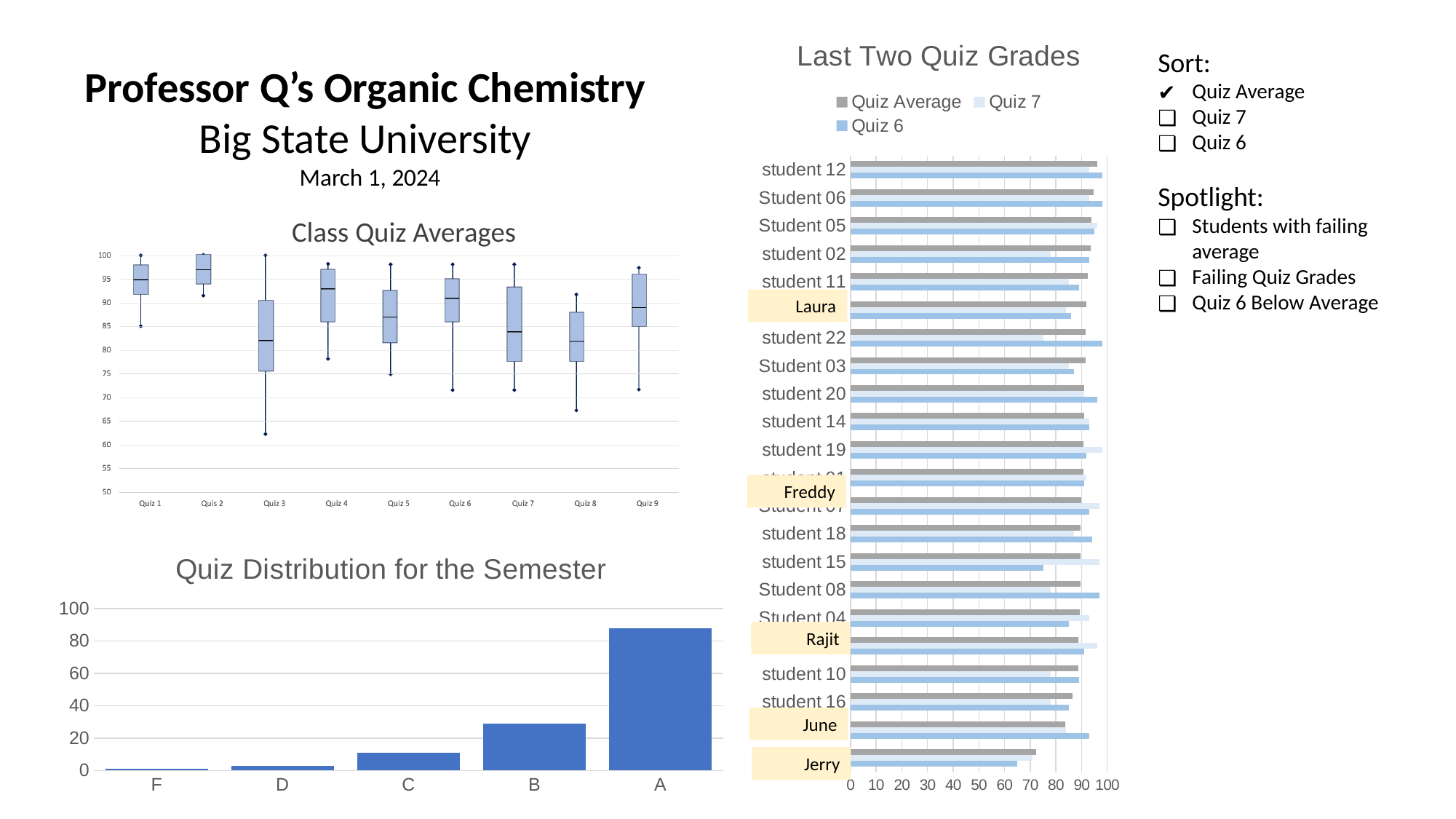
In the "Quiz Distribution for the Semester" chart, is the value for A greater or less than 80? greater What type of chart is "Quiz Distribution for the Semester"? bar chart In the "Last Two Quiz Grades" chart, is Jerry's Quiz Average greater or less than 80? less In the "Quiz Distribution for the Semester" chart, do the values rise or fall moving from F to A along the x axis? rise In the "Quiz Distribution for the Semester" chart, which is larger, the value for B or the value for D? B In the "Quiz Distribution for the Semester" chart, which grade category has the lowest bar? F In the "Last Two Quiz Grades" chart, which student has the lowest Quiz Average? Jerry How many quizzes are shown on the x axis of the "Class Quiz Averages" chart? 9 In the "Quiz Distribution for the Semester" chart, is the value for C greater or less than 20? less How many series does the legend of the "Last Two Quiz Grades" chart list? 3 In the "Quiz Distribution for the Semester" chart, which grade category has the highest bar? A In the "Quiz Distribution for the Semester" chart, how many grade categories are shown on the x axis? 5